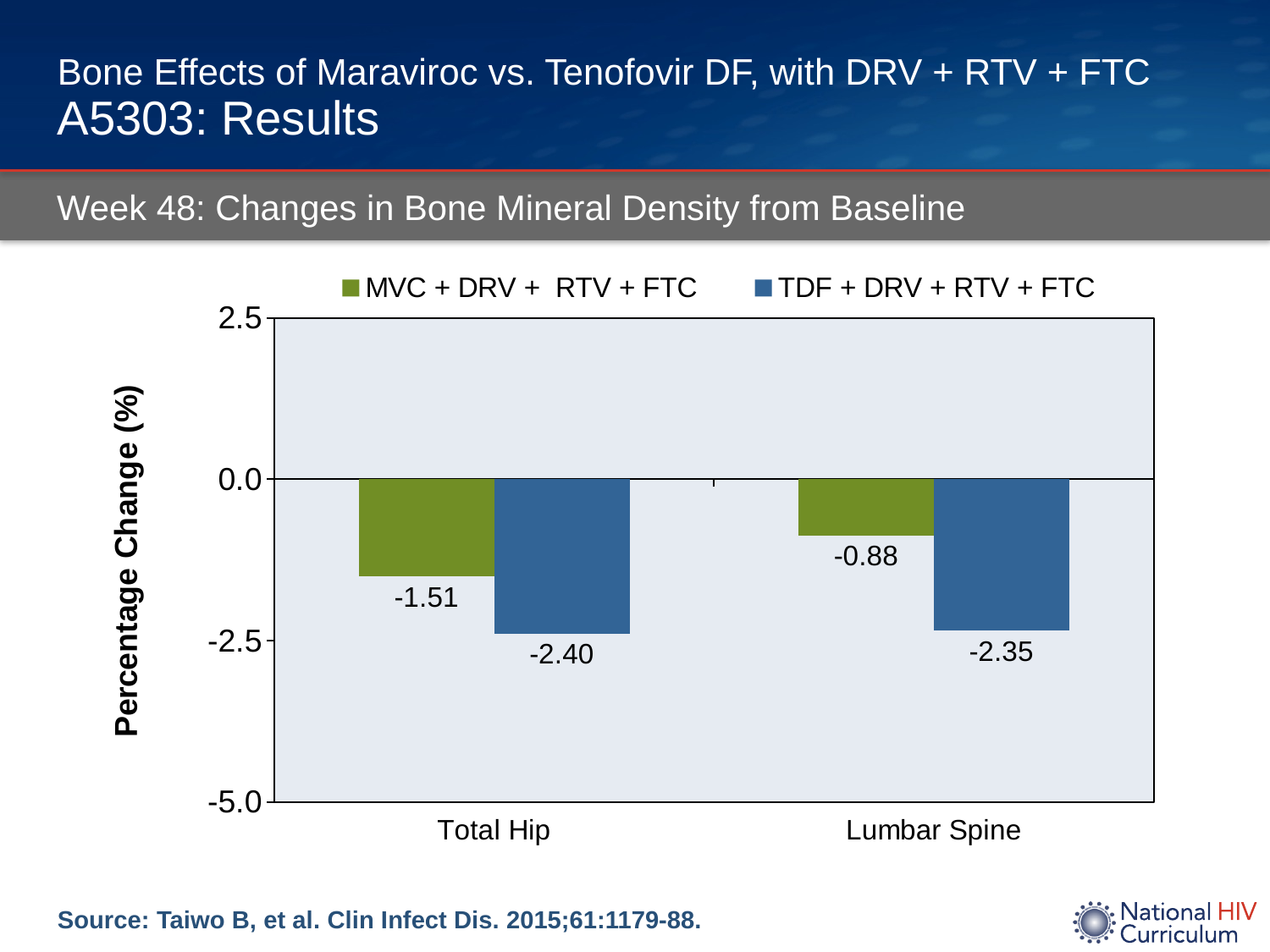
What kind of chart is shown on the slide? Bar chart Which bar shows the smallest decrease in bone mineral density? MVC + DRV + RTV + FTC at Lumbar Spine At Lumbar Spine, which group had the greater decrease in bone mineral density, MVC + DRV + RTV + FTC or TDF + DRV + RTV + FTC? TDF + DRV + RTV + FTC What is the difference between the Total Hip percentage changes for the TDF + DRV + RTV + FTC and MVC + DRV + RTV + FTC groups? 0.89 How many series does the legend list? 2 What is the difference between the Lumbar Spine percentage changes for the TDF + DRV + RTV + FTC and MVC + DRV + RTV + FTC groups? 1.47 What is the percentage change in bone mineral density at Lumbar Spine for the MVC + DRV + RTV + FTC group? -0.88 What is the percentage change in bone mineral density at Total Hip for the TDF + DRV + RTV + FTC group? -2.40 How many categories are shown on the x axis? 2 What is the percentage change in bone mineral density at Total Hip for the MVC + DRV + RTV + FTC group? -1.51 What is the percentage change in bone mineral density at Lumbar Spine for the TDF + DRV + RTV + FTC group? -2.35 Which bar shows the largest decrease in bone mineral density? TDF + DRV + RTV + FTC at Total Hip